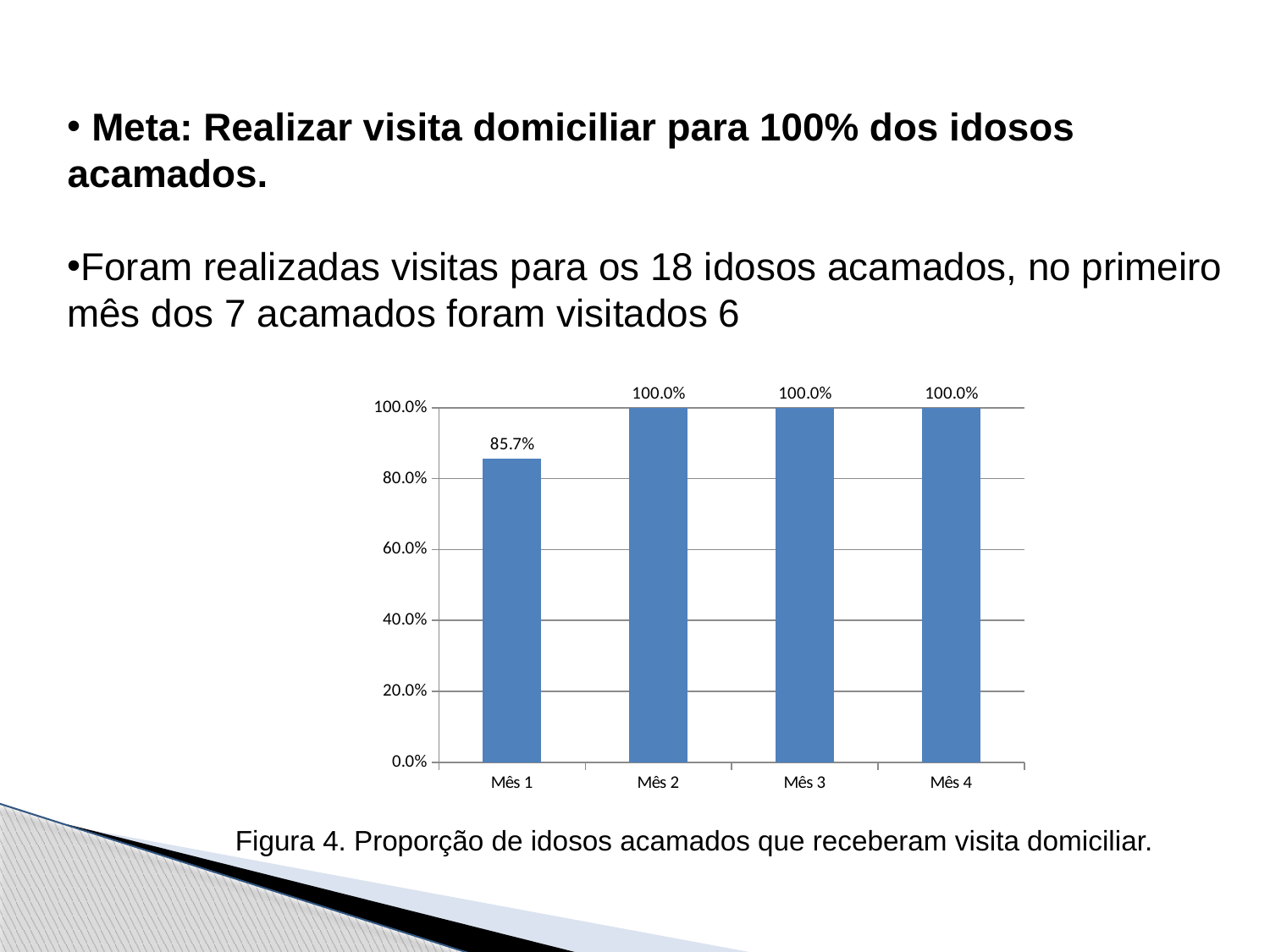
What kind of chart is shown on the slide? bar chart How many months reach 100.0%? 3 How many months are shown on the x axis? 4 Which is larger, the value for Mês 1 or the value for Mês 4? Mês 4 Is the value for Mês 1 greater or less than 80.0%? greater What is the caption of the figure below the chart? Figura 4. Proporção de idosos acamados que receberam visita domiciliar. What is the difference between the values for Mês 2 and Mês 1? 14.3% What is the highest value shown on the y axis? 100.0% Do the values rise or fall from Mês 1 to Mês 2? rise Which month has the lowest value? Mês 1 What is the value for Mês 1? 85.7% What is the value for Mês 3? 100.0%